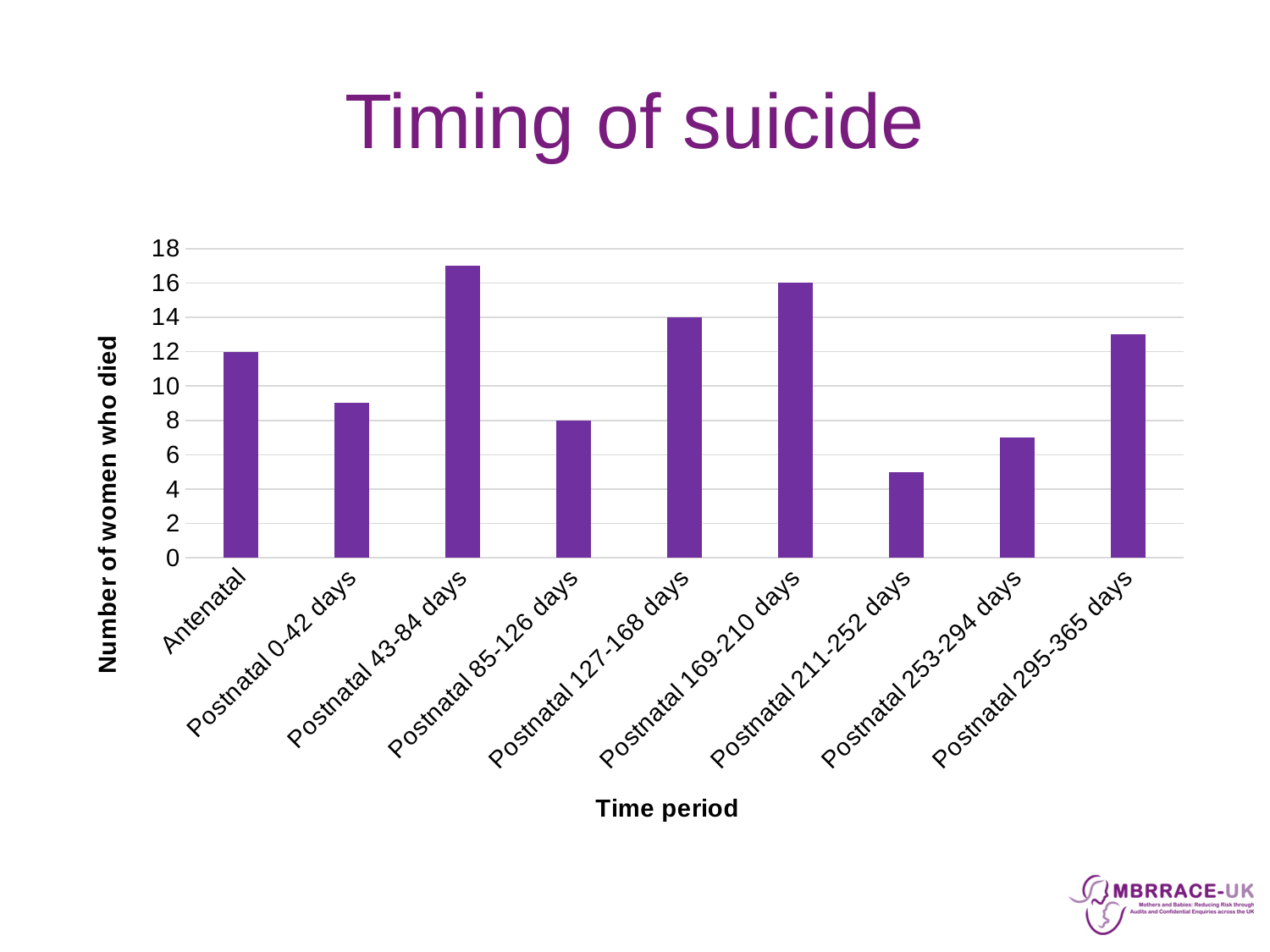
What is the label of the y axis? Number of women who died Is the value for Postnatal 211-252 days greater or less than 6? less Which time period has the lowest number of women who died? Postnatal 211-252 days What is the number of women who died in the Postnatal 169-210 days period? 16 Which time period has the highest number of women who died? Postnatal 43-84 days Is the value for Postnatal 43-84 days greater or less than 16? greater What is the number of women who died in the Antenatal period? 12 What is the number of women who died in the Postnatal 127-168 days period? 14 What is the title of the chart? Timing of suicide How many time period categories are shown on the x axis? 9 What type of chart is shown on the slide? Bar chart Which is larger, the value for Postnatal 0-42 days or the value for Postnatal 295-365 days? Postnatal 295-365 days